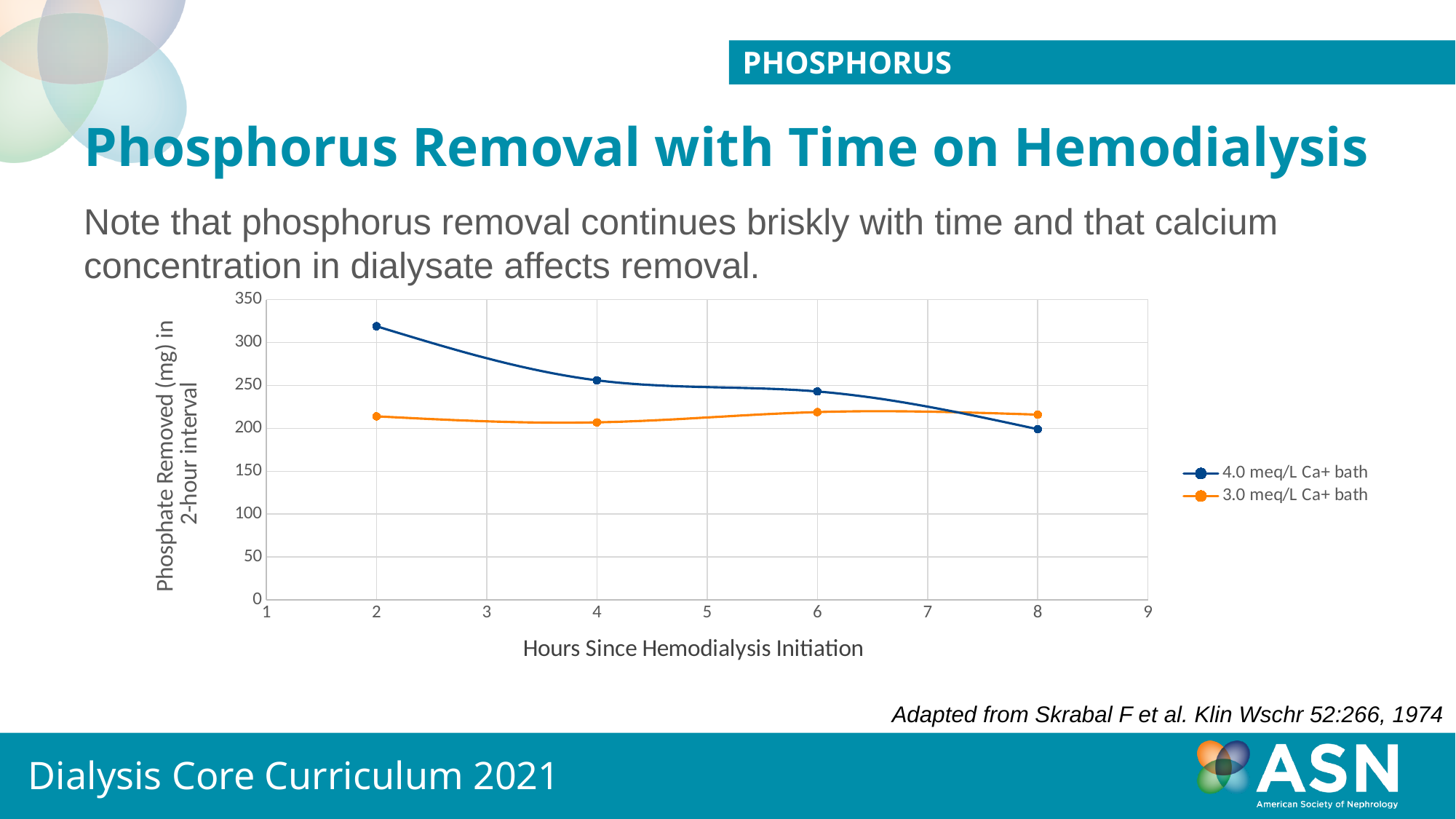
How many series does the legend list? 2 Is the value for the 4.0 meq/L Ca+ bath at hour 8 greater or less than 250? less Is the value for the 4.0 meq/L Ca+ bath at hour 2 greater or less than 300? greater Is the value for the 3.0 meq/L Ca+ bath at hour 2 greater or less than 200? greater At hour 8, which series has the larger value, 4.0 meq/L Ca+ bath or 3.0 meq/L Ca+ bath? 3.0 meq/L Ca+ bath At which hour is the 4.0 meq/L Ca+ bath series highest? 2 Does the value for the 4.0 meq/L Ca+ bath series rise or fall as hours since hemodialysis initiation increase? fall What is the title of the x axis of the chart? Hours Since Hemodialysis Initiation At which hour is the 4.0 meq/L Ca+ bath series lowest? 8 What kind of chart is shown on the slide? line chart How many data points are plotted for the 4.0 meq/L Ca+ bath series? 4 At hour 2, which series has the larger value, 4.0 meq/L Ca+ bath or 3.0 meq/L Ca+ bath? 4.0 meq/L Ca+ bath